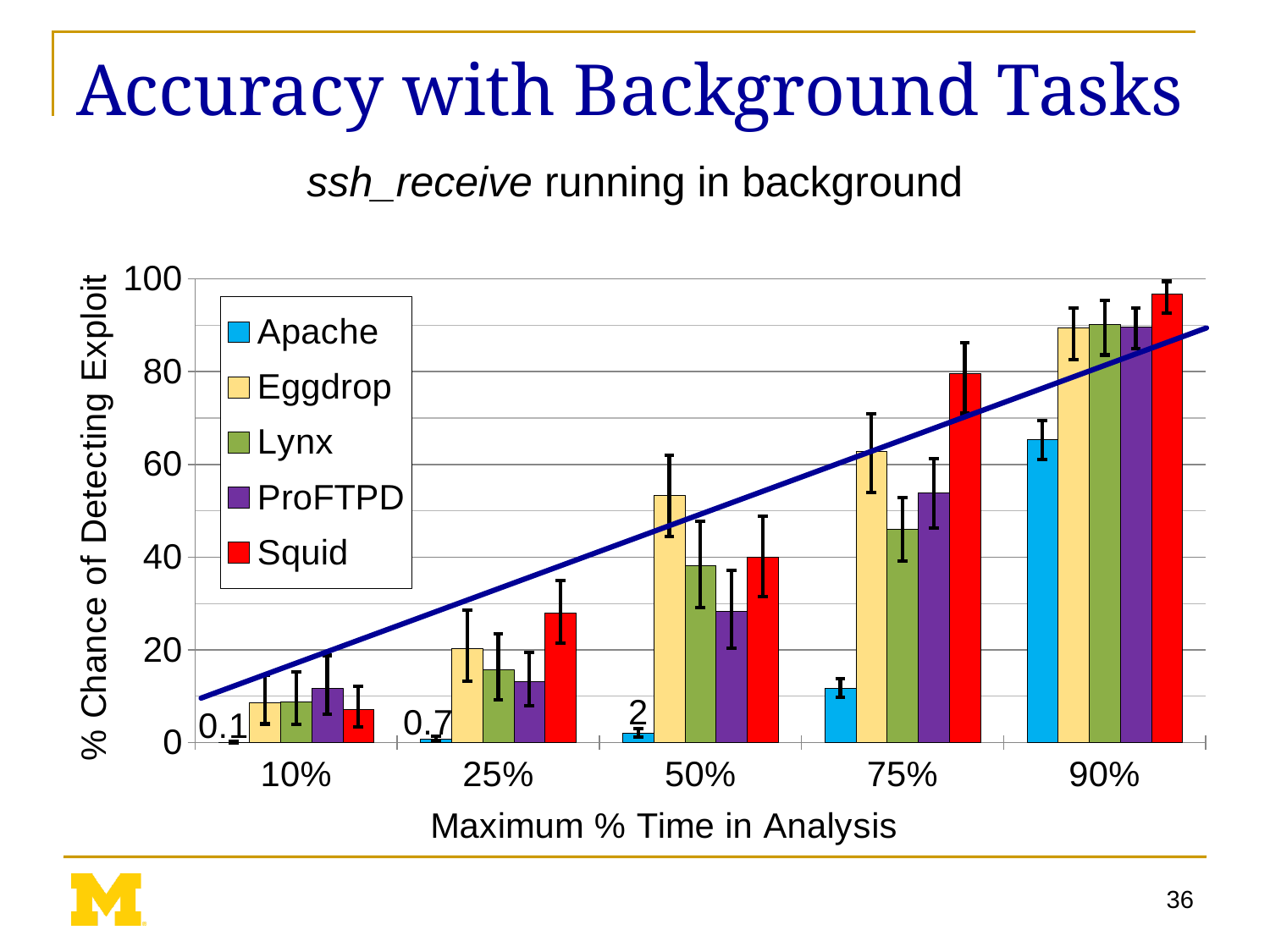
Which series has the highest value at 75% maximum time in analysis? Squid Is the value for Lynx at 25% maximum time in analysis greater or less than 20? less Is the value for Apache at 75% maximum time in analysis greater or less than 80? less How many series does the legend list? 5 What is the value for Apache at 10% maximum time in analysis? 0.1 Which series has the lowest value at 10% maximum time in analysis? Apache What is the value for Apache at 50% maximum time in analysis? 2 Is the value for Squid at 75% maximum time in analysis greater or less than 60? greater What is the difference between the Apache values at 50% and 25% maximum time in analysis? 1.3 What is the value for Apache at 25% maximum time in analysis? 0.7 At 50% maximum time in analysis, which is larger: Eggdrop or Apache? Eggdrop Do the Squid values rise or fall as maximum % time in analysis increases? rise